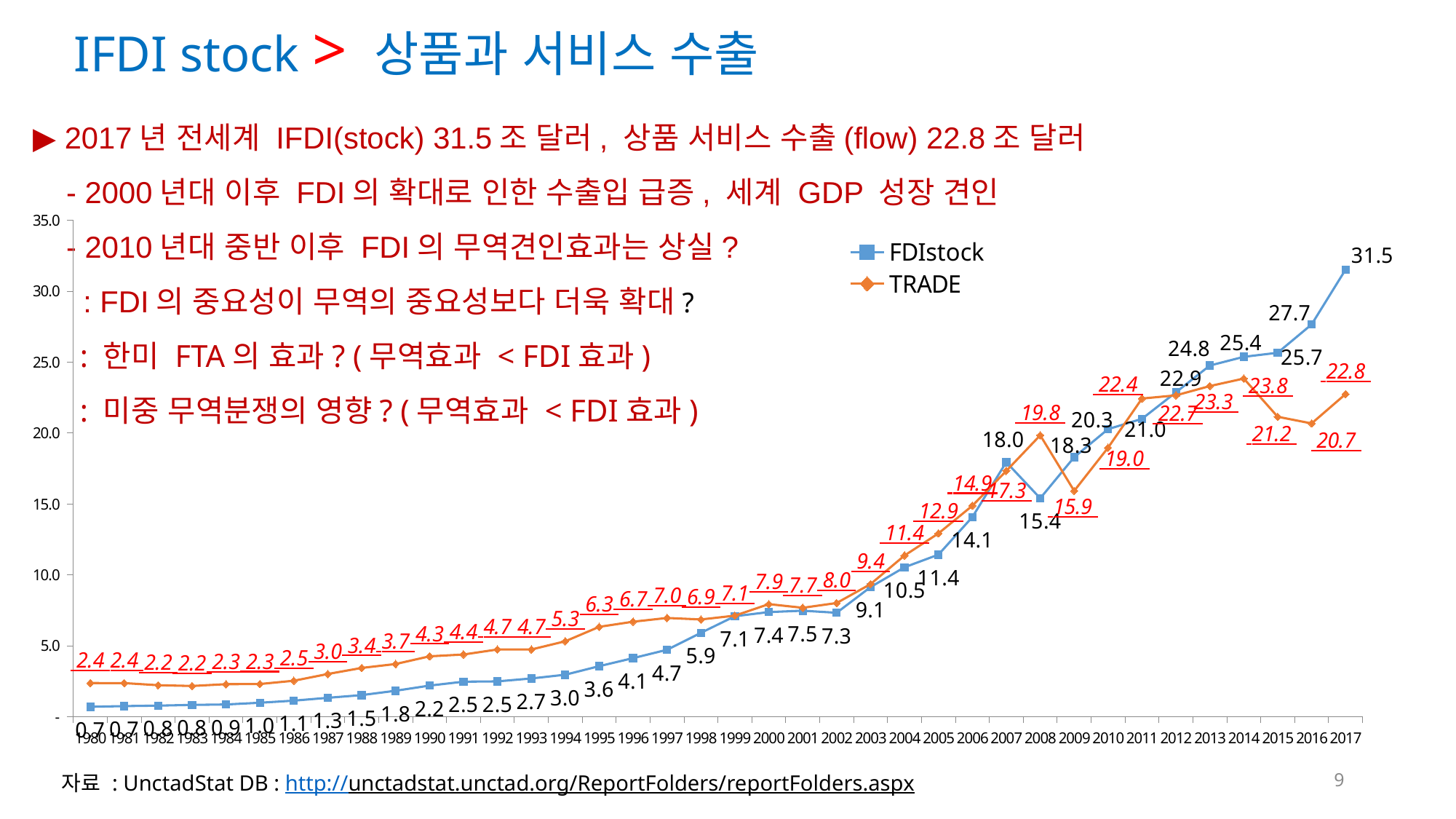
In which year does the FDIstock series reach its highest value? 2017 What is the TRADE value for 1980? 2.4 What kind of chart is shown on the slide? Line chart What is the FDIstock value for 2017? 31.5 Does the FDIstock series generally rise or fall from 1980 to 2017? Rise In 2008, which series has the larger value, FDIstock or TRADE? TRADE What is the FDIstock value for 2008? 15.4 In which year does the TRADE series reach its highest value? 2014 How many series does the legend list? 2 How many years are plotted on the x axis? 38 What is the TRADE value for 2008? 19.8 What is the difference between FDIstock and TRADE in 2017? 8.7